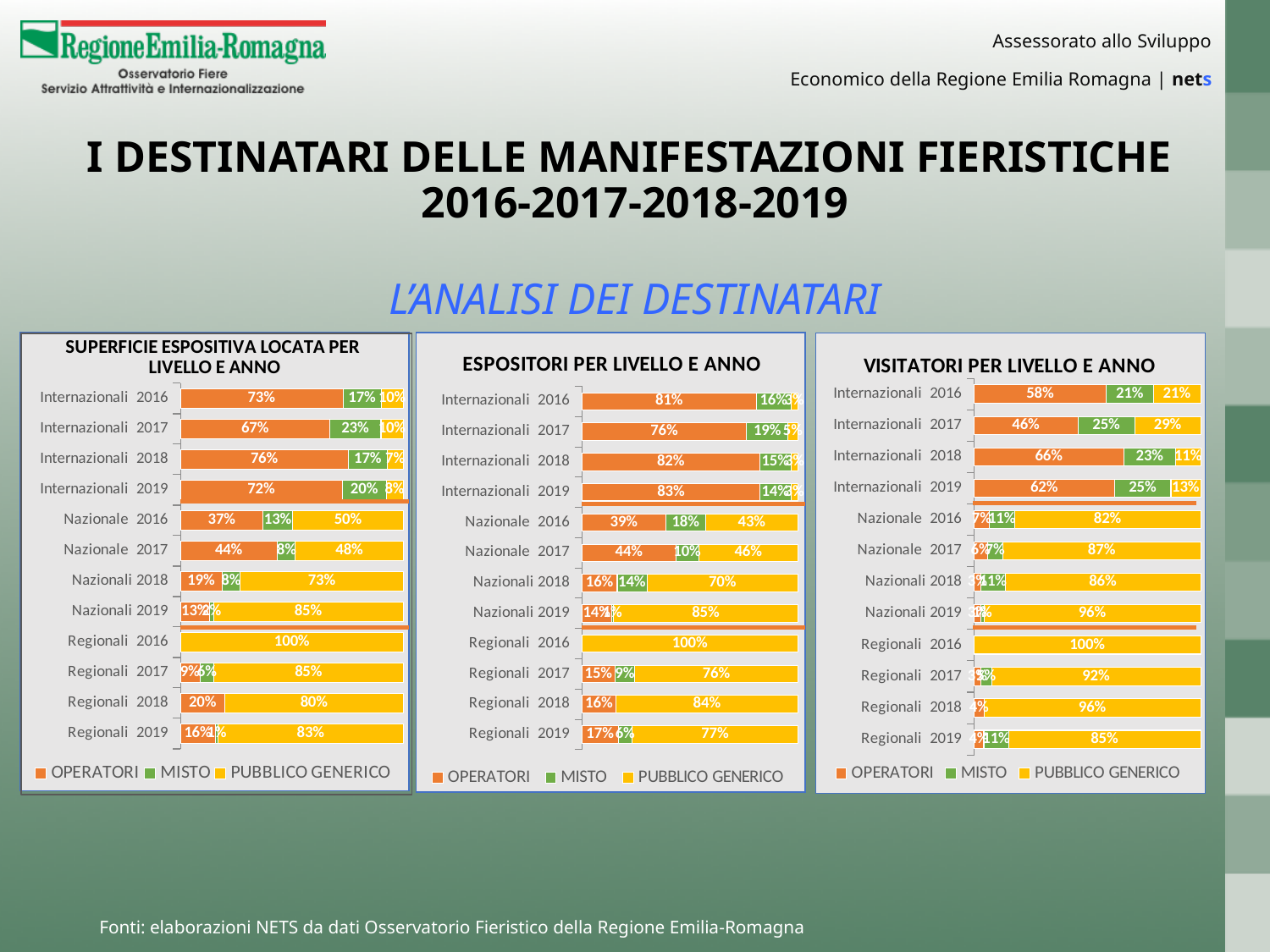
In the 'VISITATORI PER LIVELLO E ANNO' chart, what is the PUBBLICO GENERICO share for Nazionali 2019? 96% In the 'VISITATORI PER LIVELLO E ANNO' chart, what is the difference between the OPERATORI shares for Internazionali 2018 and Internazionali 2017? 20% In the 'SUPERFICIE ESPOSITIVA LOCATA PER LIVELLO E ANNO' chart, which is larger: the OPERATORI share for Nazionale 2017 or for Nazionali 2018? Nazionale 2017 In the 'ESPOSITORI PER LIVELLO E ANNO' chart, which category has the highest OPERATORI share? Internazionali 2019 In the 'ESPOSITORI PER LIVELLO E ANNO' chart, what is the OPERATORI share for Internazionali 2019? 83% In the 'ESPOSITORI PER LIVELLO E ANNO' chart, what is the PUBBLICO GENERICO share for Nazionali 2018? 70% In the 'SUPERFICIE ESPOSITIVA LOCATA PER LIVELLO E ANNO' chart, what is the PUBBLICO GENERICO share for Nazionale 2016? 50% What type of chart is the 'VISITATORI PER LIVELLO E ANNO' chart? Stacked bar chart How many series does the legend of the 'ESPOSITORI PER LIVELLO E ANNO' chart list? 3 In the 'SUPERFICIE ESPOSITIVA LOCATA PER LIVELLO E ANNO' chart, what is the PUBBLICO GENERICO share for Regionali 2018? 80% In the 'VISITATORI PER LIVELLO E ANNO' chart, what is the OPERATORI share for Internazionali 2018? 66% In the 'SUPERFICIE ESPOSITIVA LOCATA PER LIVELLO E ANNO' chart, what is the OPERATORI share for Internazionali 2016? 73%